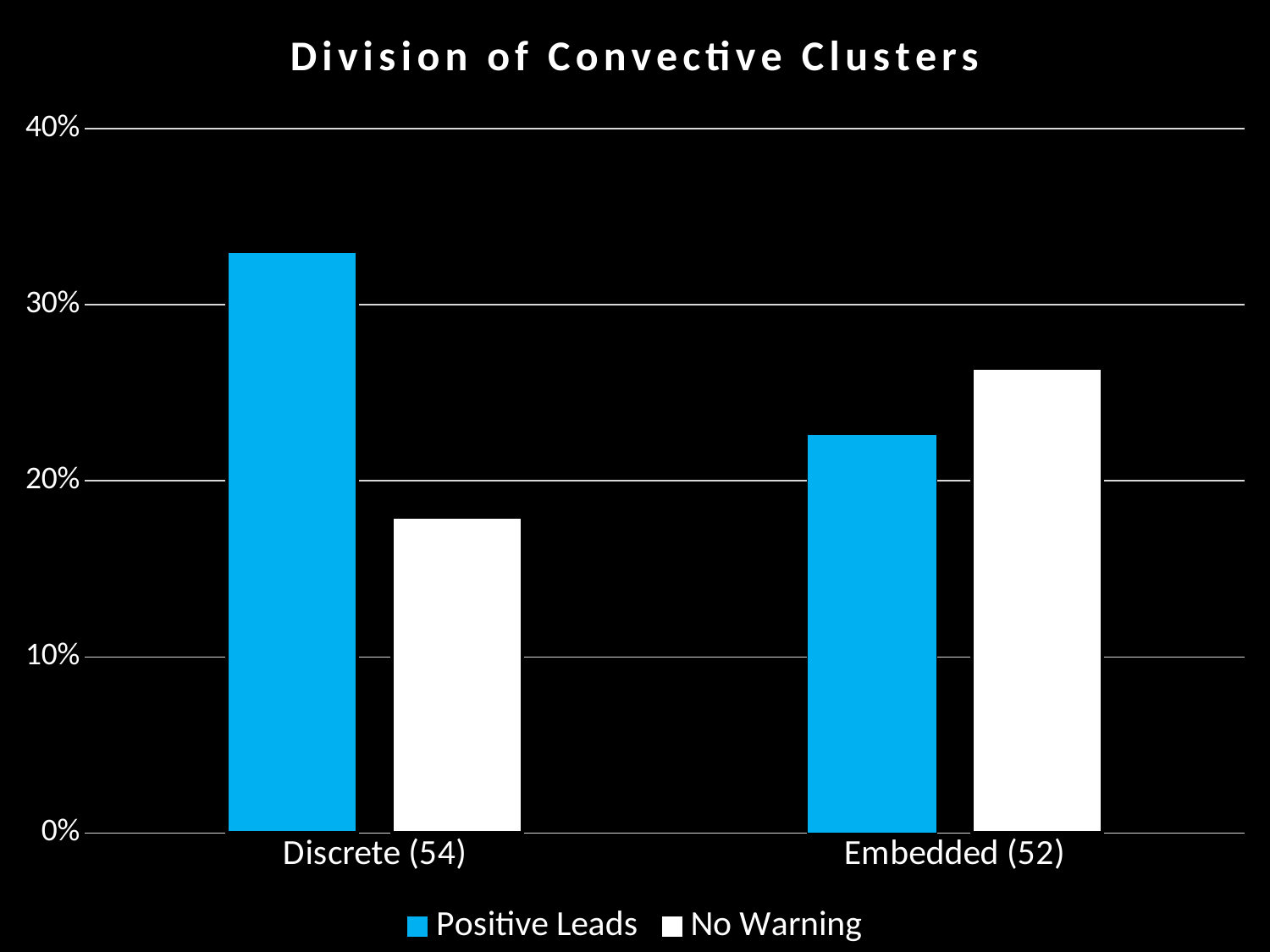
For Embedded (52), which is larger: Positive Leads or No Warning? No Warning How many series does the legend list? 2 Which series is shown in blue? Positive Leads Is the Positive Leads value for Discrete (54) greater or less than 30%? greater For Discrete (54), which is larger: Positive Leads or No Warning? Positive Leads Is the No Warning value for Discrete (54) greater or less than 20%? less How many categories are shown on the x axis? 2 What kind of chart is shown on the slide? bar chart Which bar is the shortest in the chart? No Warning for Discrete (54) Which bar is the tallest in the chart? Positive Leads for Discrete (54) What is the title of the chart? Division of Convective Clusters Is the No Warning value for Embedded (52) greater or less than 30%? less